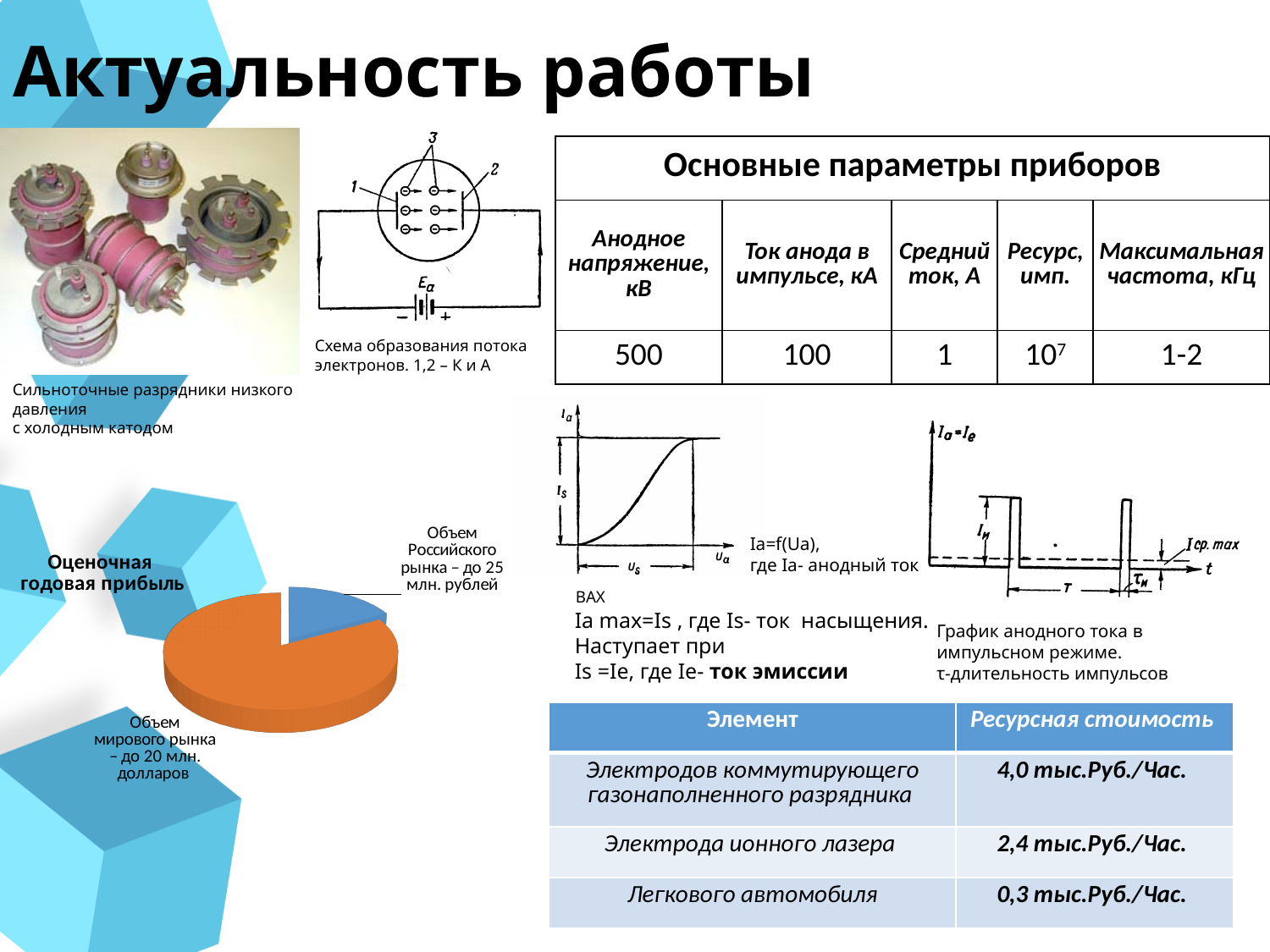
In the pie chart "Оценочная годовая прибыль", which slice is the largest? Объем мирового рынка In the pie chart "Оценочная годовая прибыль", which slice is the smallest? Объем Российского рынка How many slices does the pie chart "Оценочная годовая прибыль" have? 2 What colour is the "Объем мирового рынка" slice in the pie chart? orange What colour is the "Объем Российского рынка" slice in the pie chart? blue In the pie chart "Оценочная годовая прибыль", which slice is larger: "Объем Российского рынка" or "Объем мирового рынка"? Объем мирового рынка What kind of chart is shown under the heading "Оценочная годовая прибыль"? pie chart